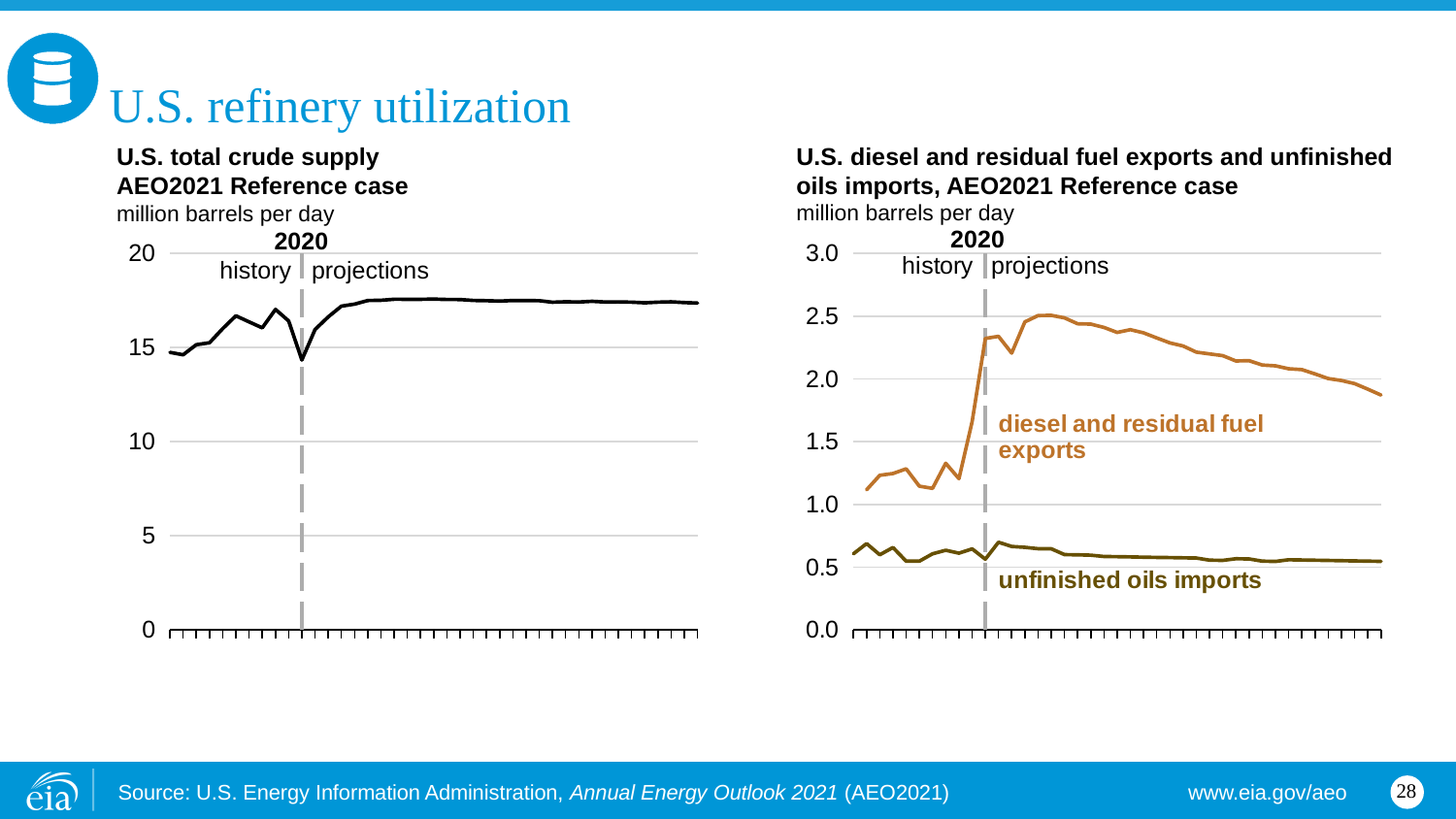
On the right chart, is the value of diesel and residual fuel exports at the start of the history period greater or less than 1.5? less On the right chart, do diesel and residual fuel exports rise or fall over the projection period after their peak around 2025? fall On the left chart, is U.S. total crude supply during the projection period greater or less than 15 million barrels per day? greater How many series are plotted on the left chart, 'U.S. total crude supply'? 1 How many series are plotted on the right chart, 'U.S. diesel and residual fuel exports and unfinished oils imports'? 2 On the right chart, are unfinished oils imports greater or less than 1.0 million barrels per day throughout the whole period? less What unit is used on the y axis of both charts? million barrels per day What kind of chart is the 'U.S. total crude supply' chart on the left? line chart What year marks the boundary between history and projections on both charts? 2020 On the right chart, which series has higher values throughout: diesel and residual fuel exports or unfinished oils imports? diesel and residual fuel exports What kind of chart is the 'U.S. diesel and residual fuel exports and unfinished oils imports' chart on the right? line chart